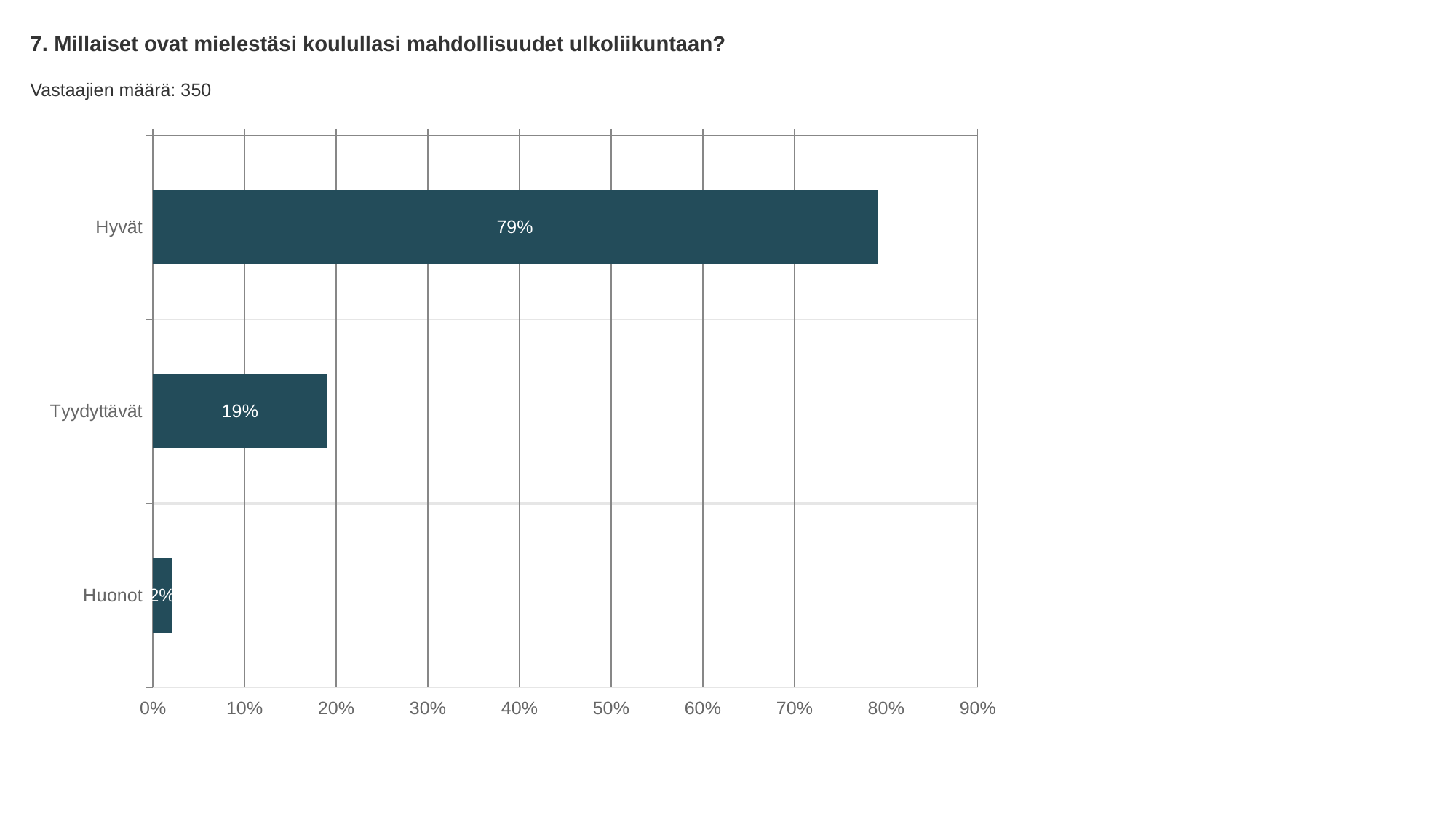
What is the difference between the values for Tyydyttävät and Huonot? 17% What is the value for Hyvät? 79% What is the difference between the values for Hyvät and Tyydyttävät? 60% Which is larger, the value for Tyydyttävät or the value for Huonot? Tyydyttävät Which category has the highest value? Hyvät Which category has the lowest value? Huonot How many respondents (Vastaajien määrä) does the slide report? 350 What is the value for Huonot? 2% What kind of chart is shown on the slide? bar chart Is the value for Hyvät greater or less than 70%? greater How many categories are shown in the chart? 3 What is the value for Tyydyttävät? 19%